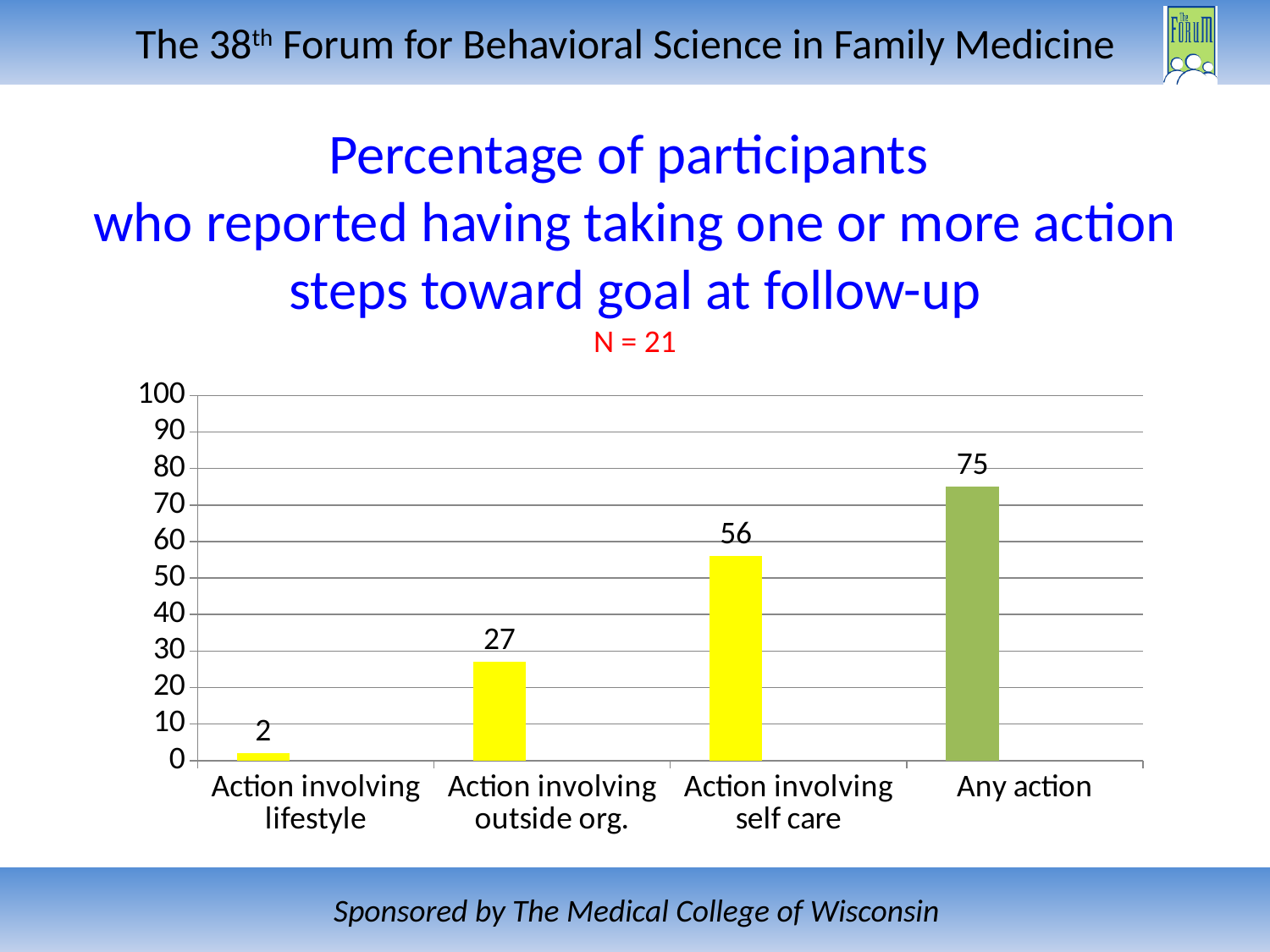
What is the difference between the values for Any action and Action involving self care? 19 Which is larger, the value for Action involving outside org. or the value for Action involving self care? Action involving self care Which category has the lowest value? Action involving lifestyle Is the value for Any action greater or less than 70? greater How many categories are shown on the x axis? 4 What is the value for Action involving outside org.? 27 What is the value for Action involving self care? 56 What is the value for Action involving lifestyle? 2 What is the value for Any action? 75 What sample size (N) is stated above the chart? N = 21 Which category has the highest value? Any action What kind of chart is shown on the slide? bar chart